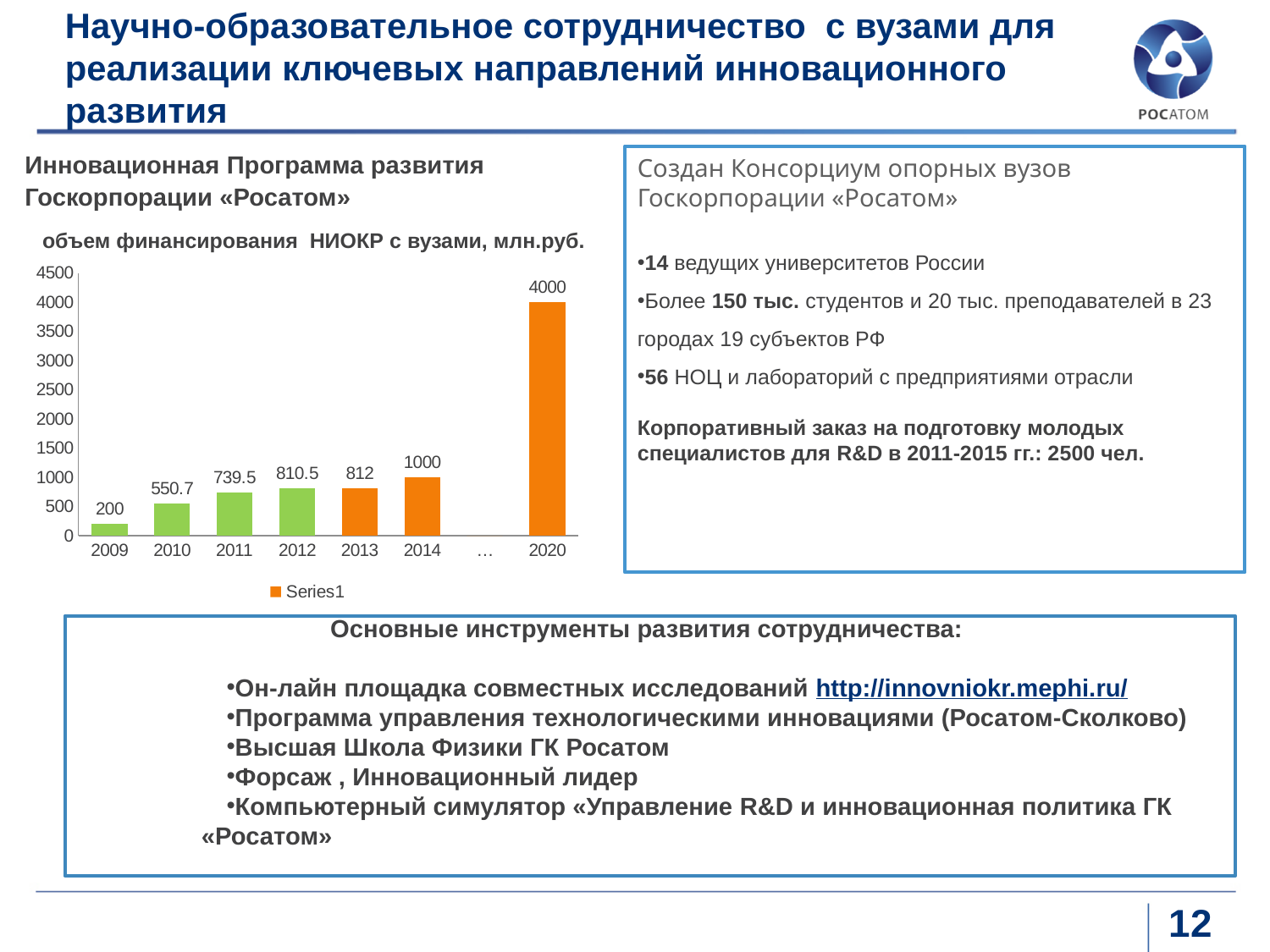
Which year has the lowest value in the chart? 2009 What kind of chart is shown on the slide? bar chart What is the difference between the values for 2020 and 2014? 3000 How many bars are plotted in the chart? 7 Which year has the highest value in the chart? 2020 What is the value for 2010 in the chart? 550.7 Which is larger, the value for 2011 or the value for 2014? 2014 What is the value for 2020 in the chart? 4000 What is the value for 2012 in the chart? 810.5 Do the values rise or fall from 2009 to 2020? rise What is the difference between the values for 2010 and 2009? 350.7 What is the value for 2009 in the chart? 200